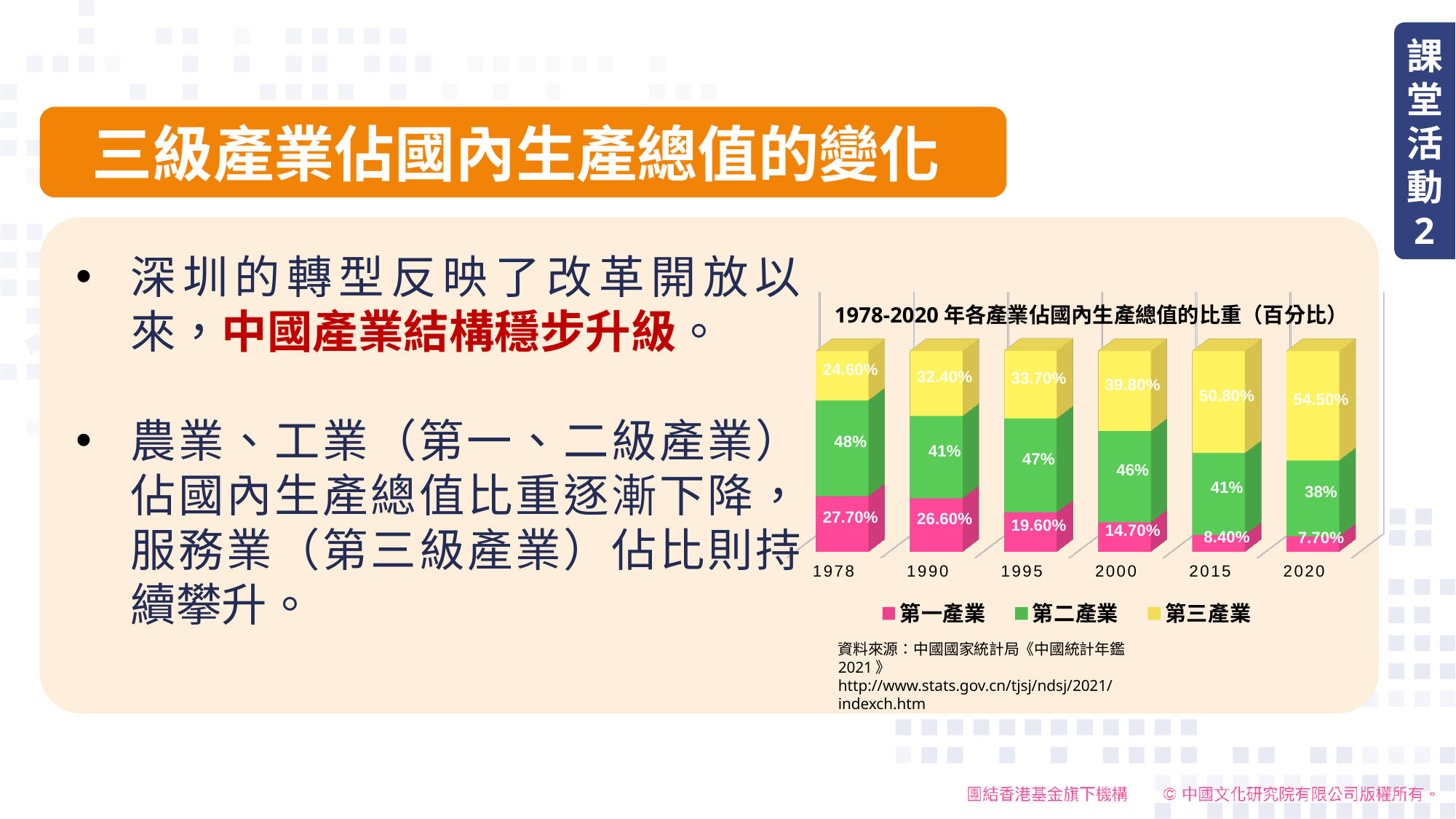
What is the difference between the 第三產業 share in 2020 and in 1978? 29.90% What is the value for 第二產業 in 1995? 47% What is the value for 第一產業 in 1978? 27.70% Which is larger in 2015: the 第二產業 share or the 第三產業 share? 第三產業 Does the 第一產業 share rise or fall from 1978 to 2020? Fall What is the value for 第三產業 in 2020? 54.50% In which year is the 第三產業 share the highest? 2020 How many years are shown on the x axis of the chart? 6 What kind of chart is shown on the slide? Stacked bar chart What is the title of the chart? 1978-2020 年各產業佔國內生產總值的比重（百分比） How many series does the chart legend list? 3 In which year is the 第一產業 share the lowest? 2020